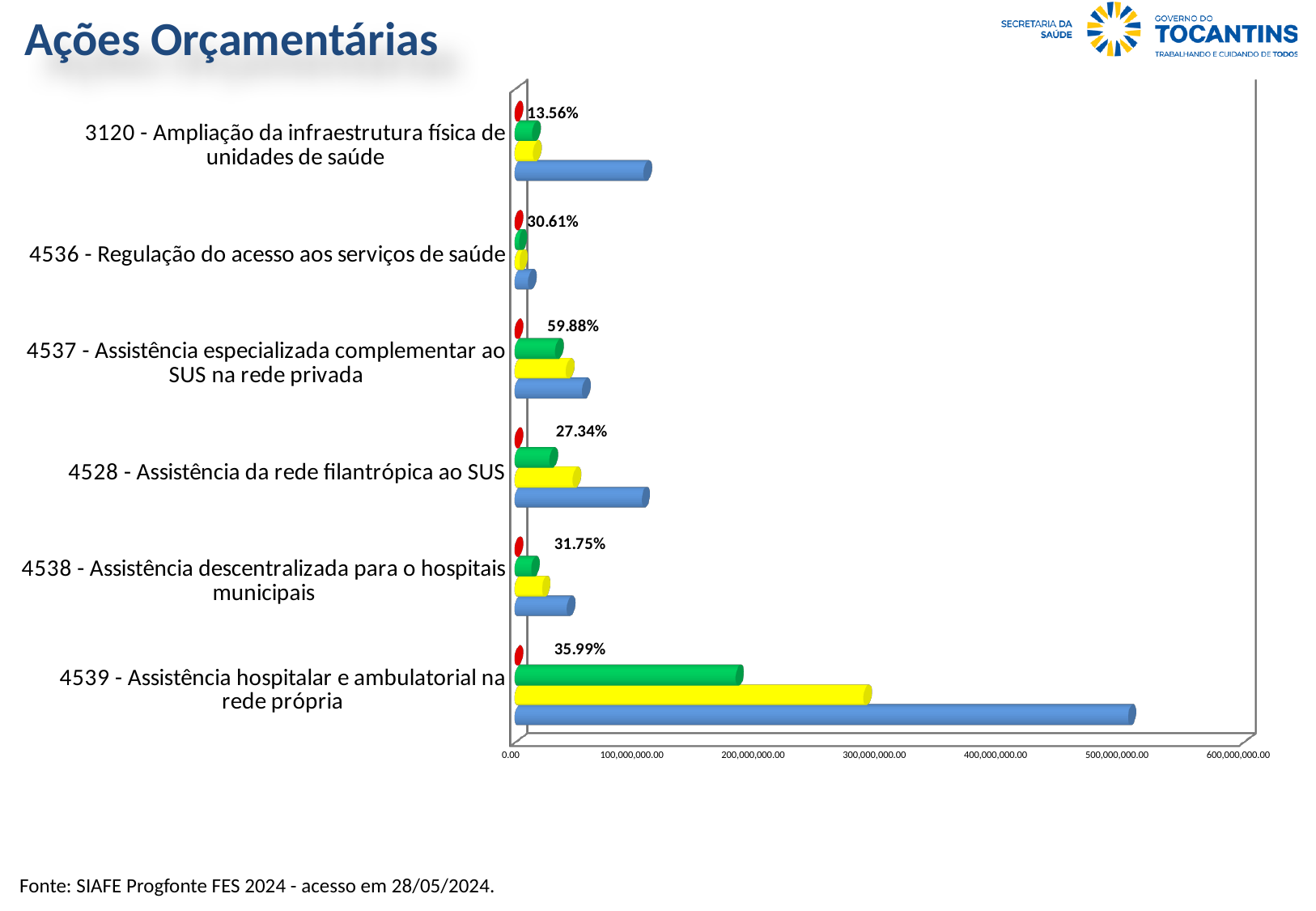
Which category has the lowest percentage label? 3120 - Ampliação da infraestrutura física de unidades de saúde What is the difference between the percentage labels for 4537 and 3120? 46.32% Which category has the highest percentage label? 4537 - Assistência especializada complementar ao SUS na rede privada What percentage is shown for the category '3120 - Ampliação da infraestrutura física de unidades de saúde'? 13.56% Is the value of the blue bar for '4536 - Regulação do acesso aos serviços de saúde' greater or less than 100,000,000.00? less Which category has the longest blue bar? 4539 - Assistência hospitalar e ambulatorial na rede própria What percentage is shown for the category '4539 - Assistência hospitalar e ambulatorial na rede própria'? 35.99% What kind of chart is shown on the slide? Bar chart How many categories (budget actions) are shown on the chart? 6 What percentage is shown for the category '4537 - Assistência especializada complementar ao SUS na rede privada'? 59.88% What percentage is shown for the category '4536 - Regulação do acesso aos serviços de saúde'? 30.61%